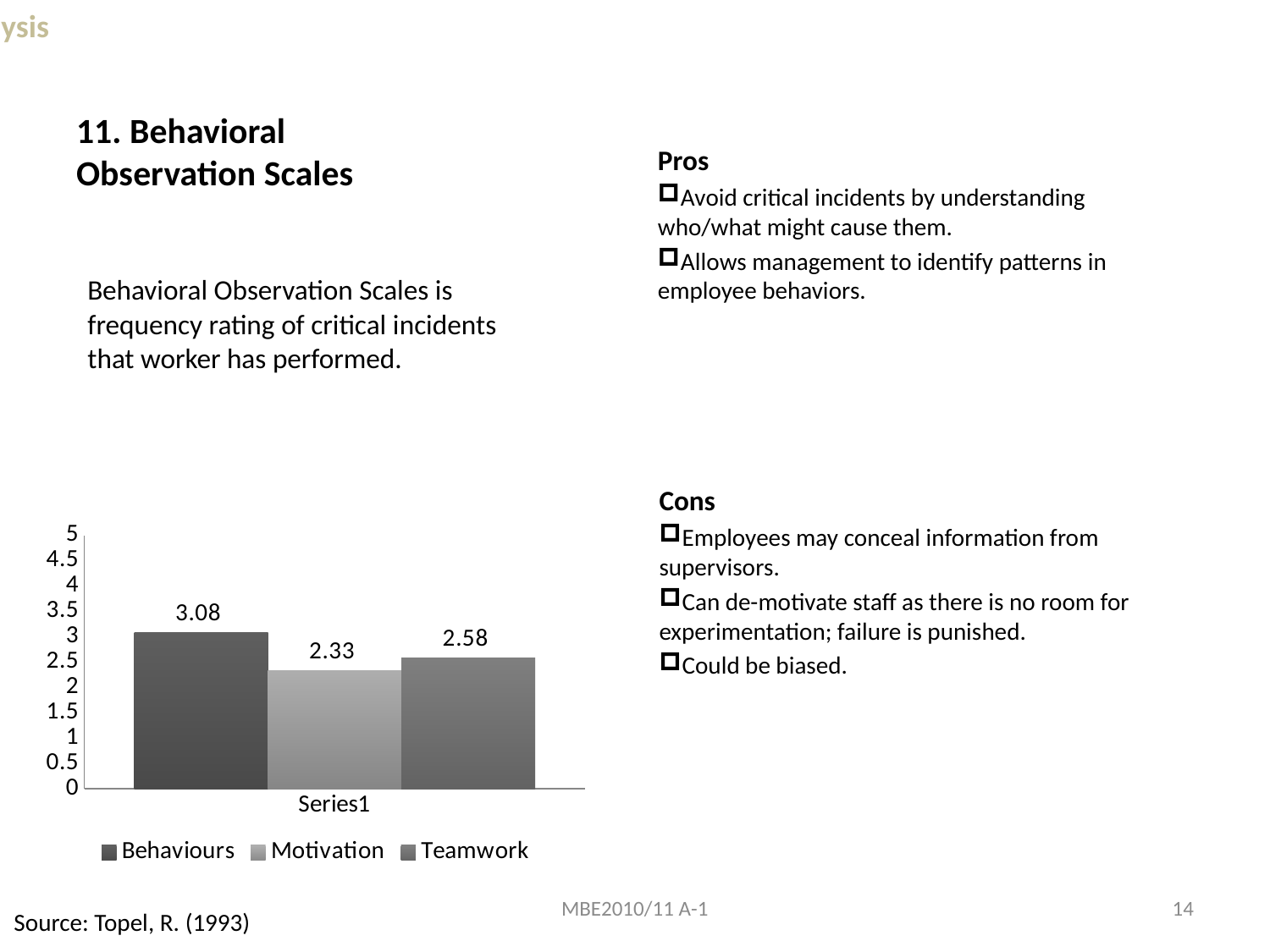
What is the difference between the Teamwork value and the Motivation value? 0.25 Is the value for Behaviours greater or less than 3? greater What is the difference between the Behaviours value and the Motivation value? 0.75 Which is larger, the value for Teamwork or the value for Motivation? Teamwork Which series has the highest value? Behaviours How many series does the legend list? 3 What is the value for Motivation? 2.33 Which series has the lowest value? Motivation What is the value for Behaviours? 3.08 What is the value for Teamwork? 2.58 What is the category label shown on the x axis of the chart? Series1 What kind of chart is shown on the slide? bar chart